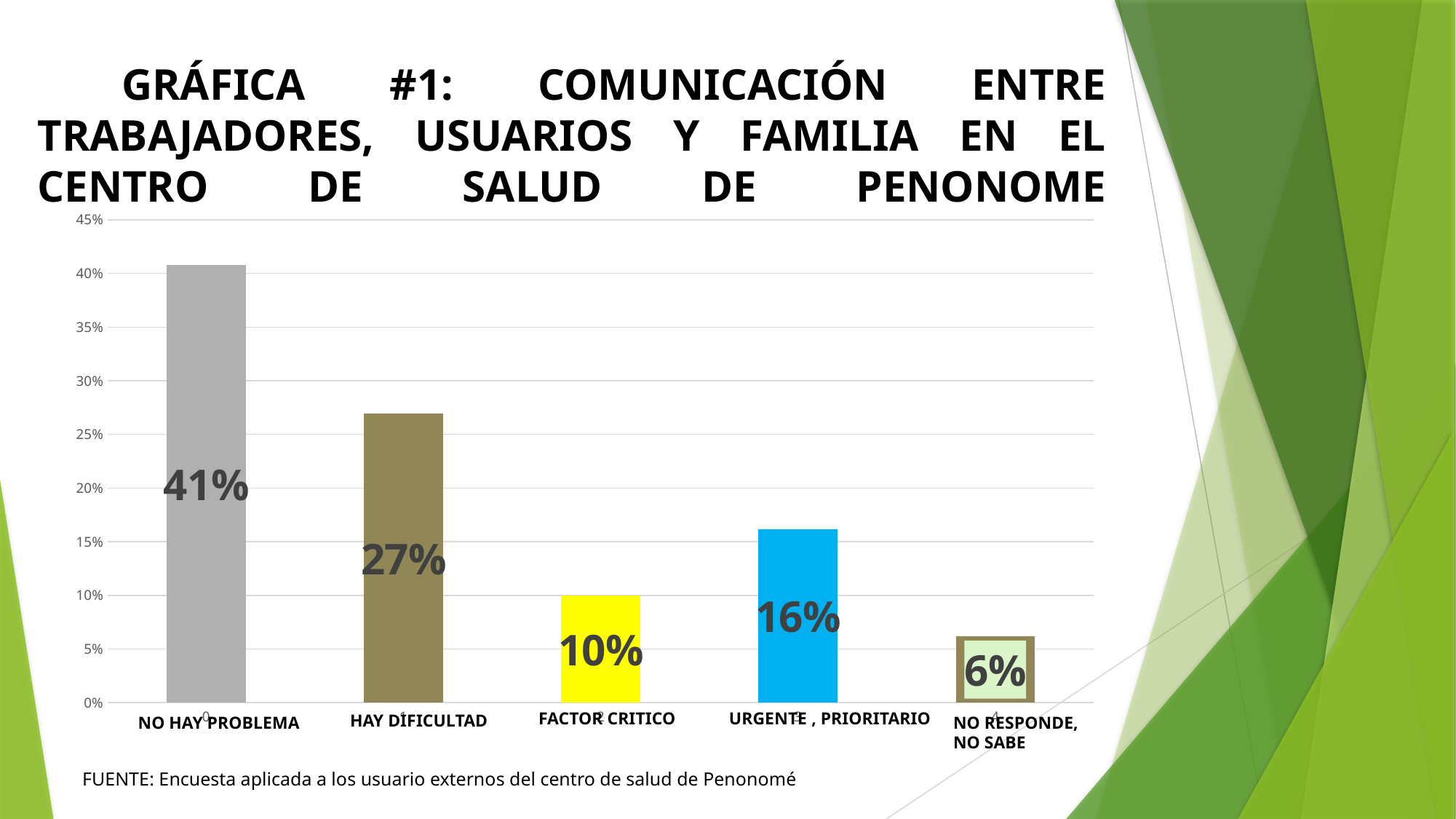
Which category has the lowest value? NO RESPONDE, NO SABE Which category has the highest value? NO HAY PROBLEMA What colour is the bar for FACTOR CRITICO? Yellow What is the difference between the values for NO HAY PROBLEMA and HAY DIFICULTAD? 14% What is the value for HAY DIFICULTAD? 27% How many categories are shown in the chart? 5 What is the value for NO HAY PROBLEMA? 41% Which is larger, the value for FACTOR CRITICO or the value for URGENTE , PRIORITARIO? URGENTE , PRIORITARIO What is the value for URGENTE , PRIORITARIO? 16% What is the value for FACTOR CRITICO? 10% What is the value for NO RESPONDE, NO SABE? 6% What kind of chart is shown on the slide? Bar chart